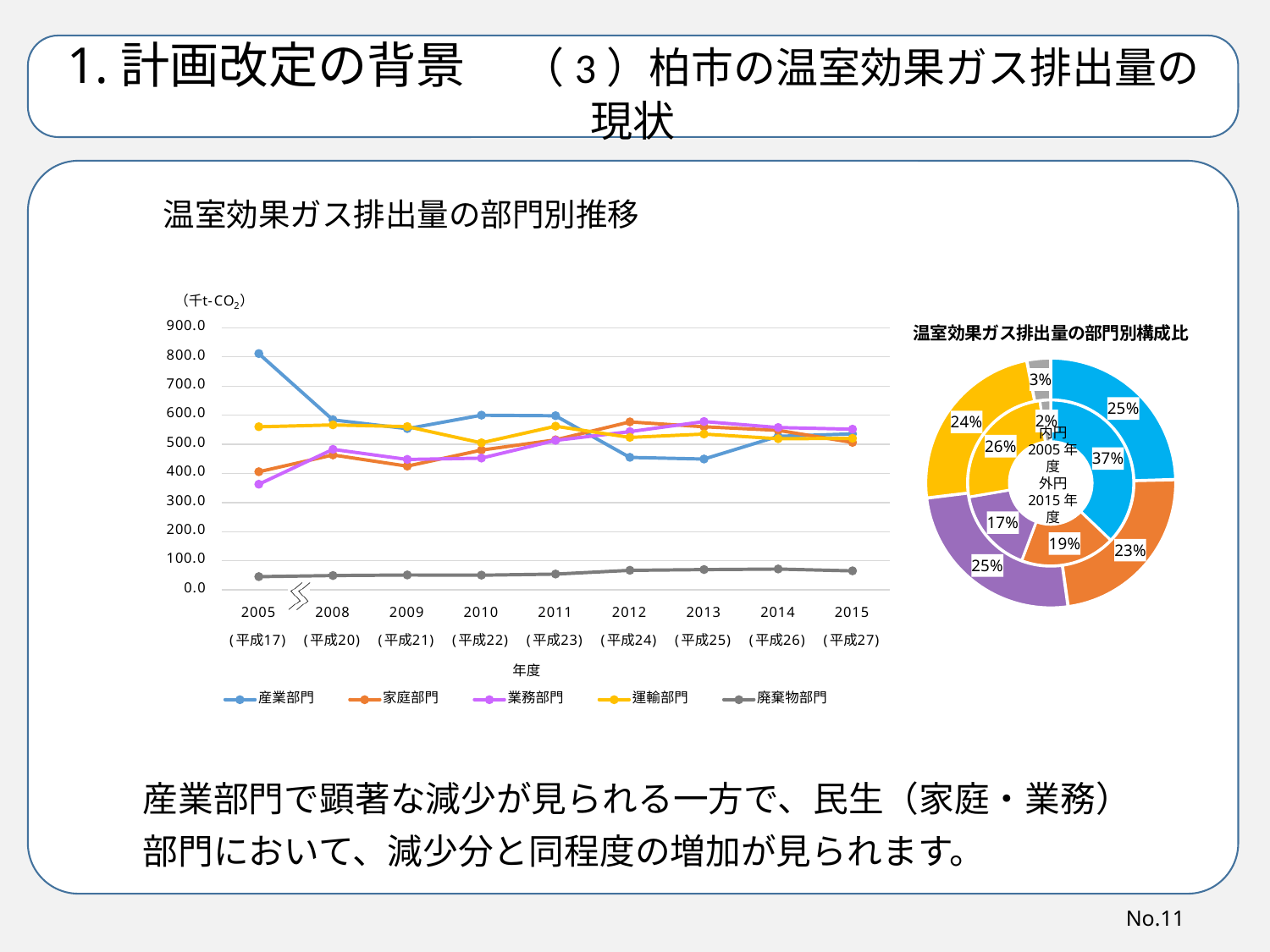
What kind of chart is the chart titled 温室効果ガス排出量の部門別推移? line chart In the doughnut chart 温室効果ガス排出量の部門別構成比, what share does the blue segment have in the inner ring (2005年度)? 37% In the line chart 温室効果ガス排出量の部門別推移, which is larger in 2005, 産業部門 or 運輸部門? 産業部門 In the line chart 温室効果ガス排出量の部門別推移, is the value for 産業部門 in 2005 greater or less than 700.0? greater In the line chart 温室効果ガス排出量の部門別推移, which series has the lowest value in 2015? 廃棄物部門 In the line chart 温室効果ガス排出量の部門別推移, how many years are shown on the x axis? 9 In the line chart 温室効果ガス排出量の部門別推移, does the 産業部門 series rise or fall from 2005 to 2015? fall In the line chart 温室効果ガス排出量の部門別推移, which series has the highest value in 2005? 産業部門 In the doughnut chart 温室効果ガス排出量の部門別構成比, what share does the orange segment have in the outer ring (2015年度)? 23% In the line chart 温室効果ガス排出量の部門別推移, how many series does the legend list? 5 In the line chart 温室効果ガス排出量の部門別推移, is the value for 廃棄物部門 in 2010 greater or less than 100.0? less In the line chart 温室効果ガス排出量の部門別推移, is the value for 業務部門 in 2005 greater or less than 400.0? less